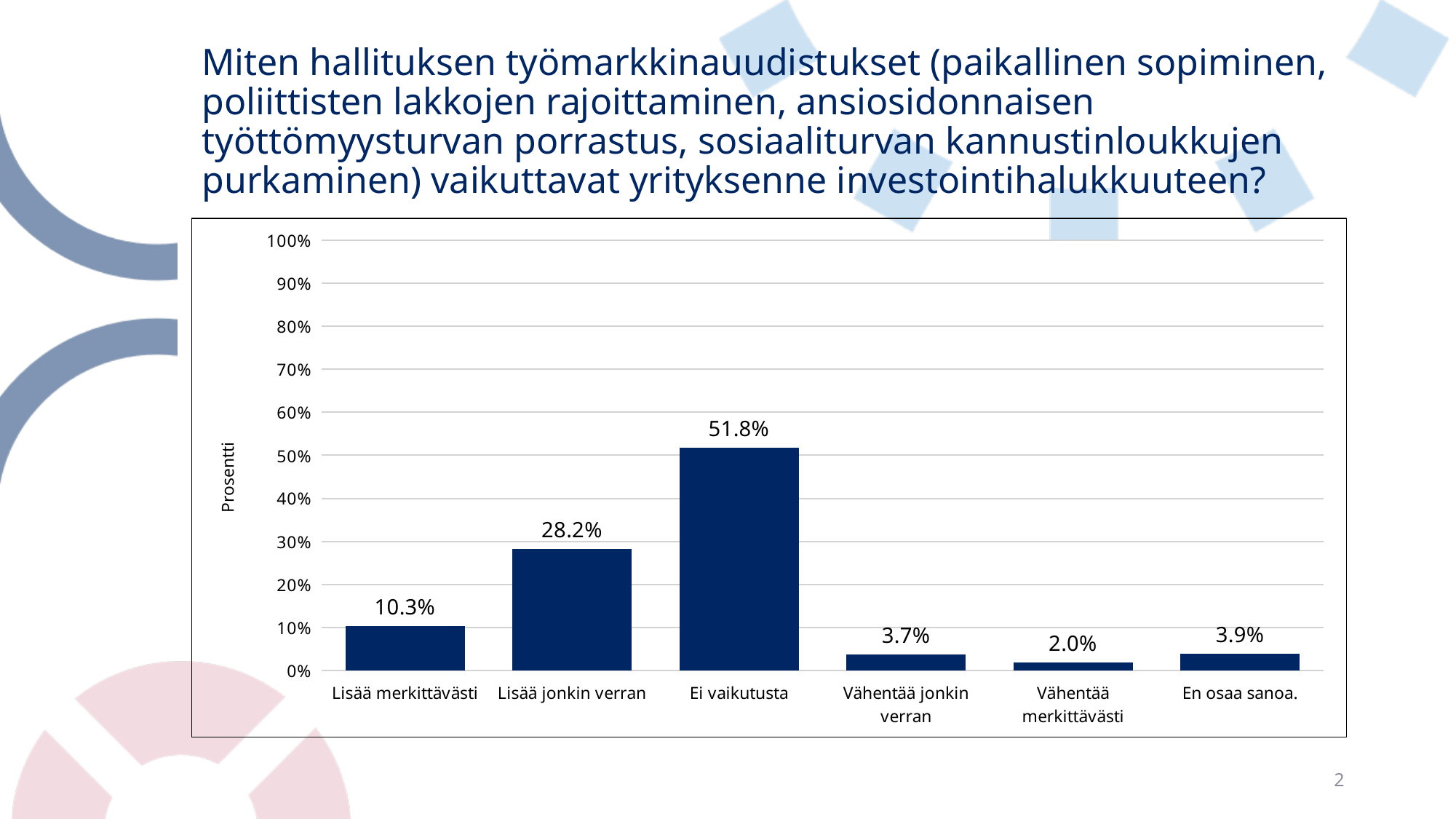
What is the difference between the values for "Ei vaikutusta" and "Lisää jonkin verran"? 23.6% What is the value for "Vähentää merkittävästi"? 2.0% What is the value for "En osaa sanoa."? 3.9% Which is larger, the value for "Lisää merkittävästi" or the value for "Vähentää jonkin verran"? Lisää merkittävästi How many categories are shown on the x axis? 6 Is the value for "Lisää jonkin verran" greater or less than 30%? less Which category has the lowest value? Vähentää merkittävästi What is the value for "Lisää jonkin verran"? 28.2% What is the value for "Ei vaikutusta"? 51.8% Which category has the highest value? Ei vaikutusta What kind of chart is shown on the slide? bar chart What is the label of the vertical axis? Prosentti